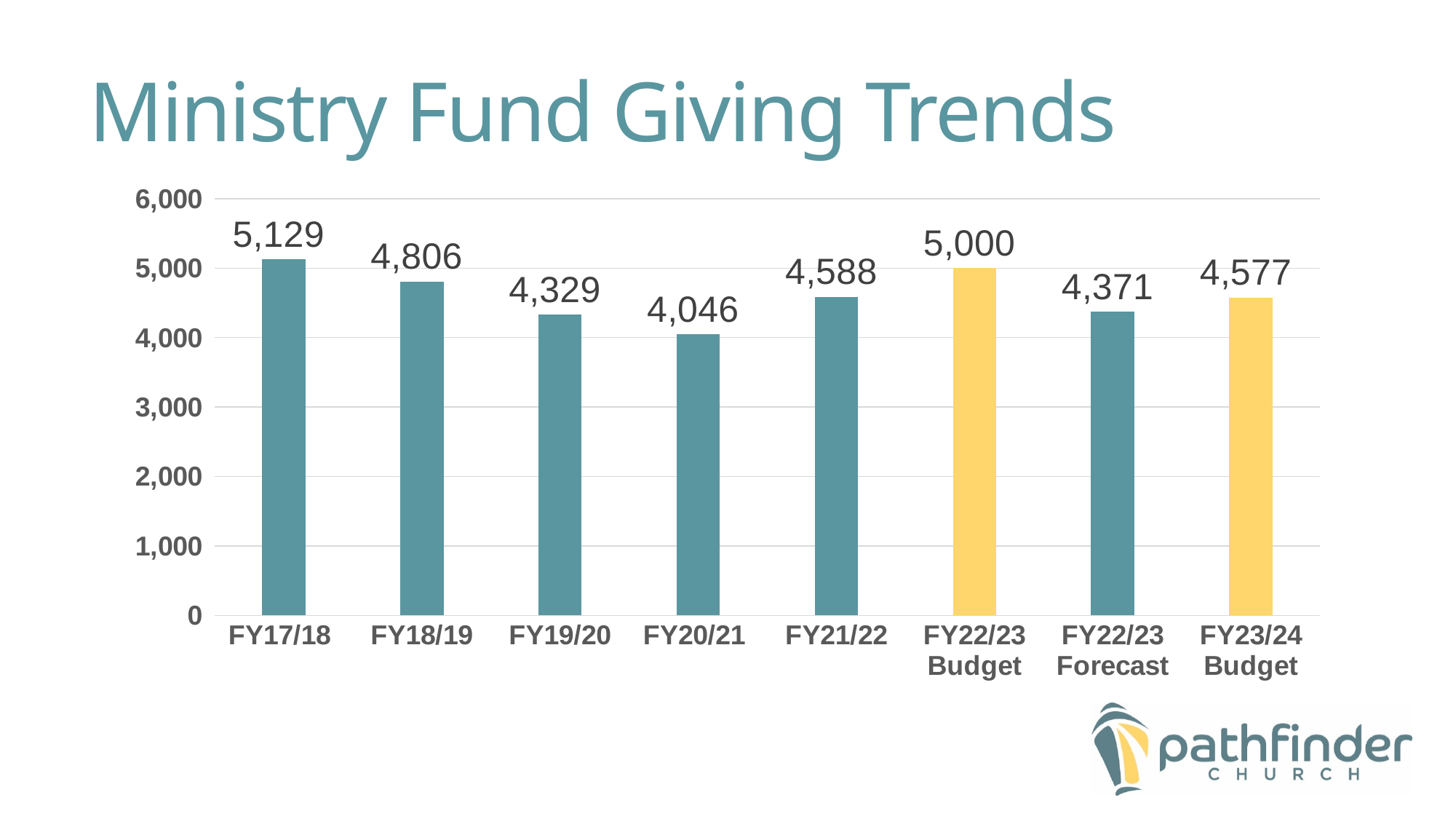
How many categories are shown on the x axis? 8 What is the title of the chart? Ministry Fund Giving Trends What is the difference between the FY22/23 Budget and the FY22/23 Forecast? 629 Is the value for FY19/20 greater or less than 4,000? greater What is the value for FY23/24 Budget? 4,577 Which category has the lowest value? FY20/21 What is the value for FY17/18? 5,129 What is the value for FY20/21? 4,046 What is the value for FY22/23 Forecast? 4,371 What kind of chart is shown on the slide? Bar chart Which is larger, the value for FY18/19 or the value for FY21/22? FY18/19 Which category has the highest value? FY17/18